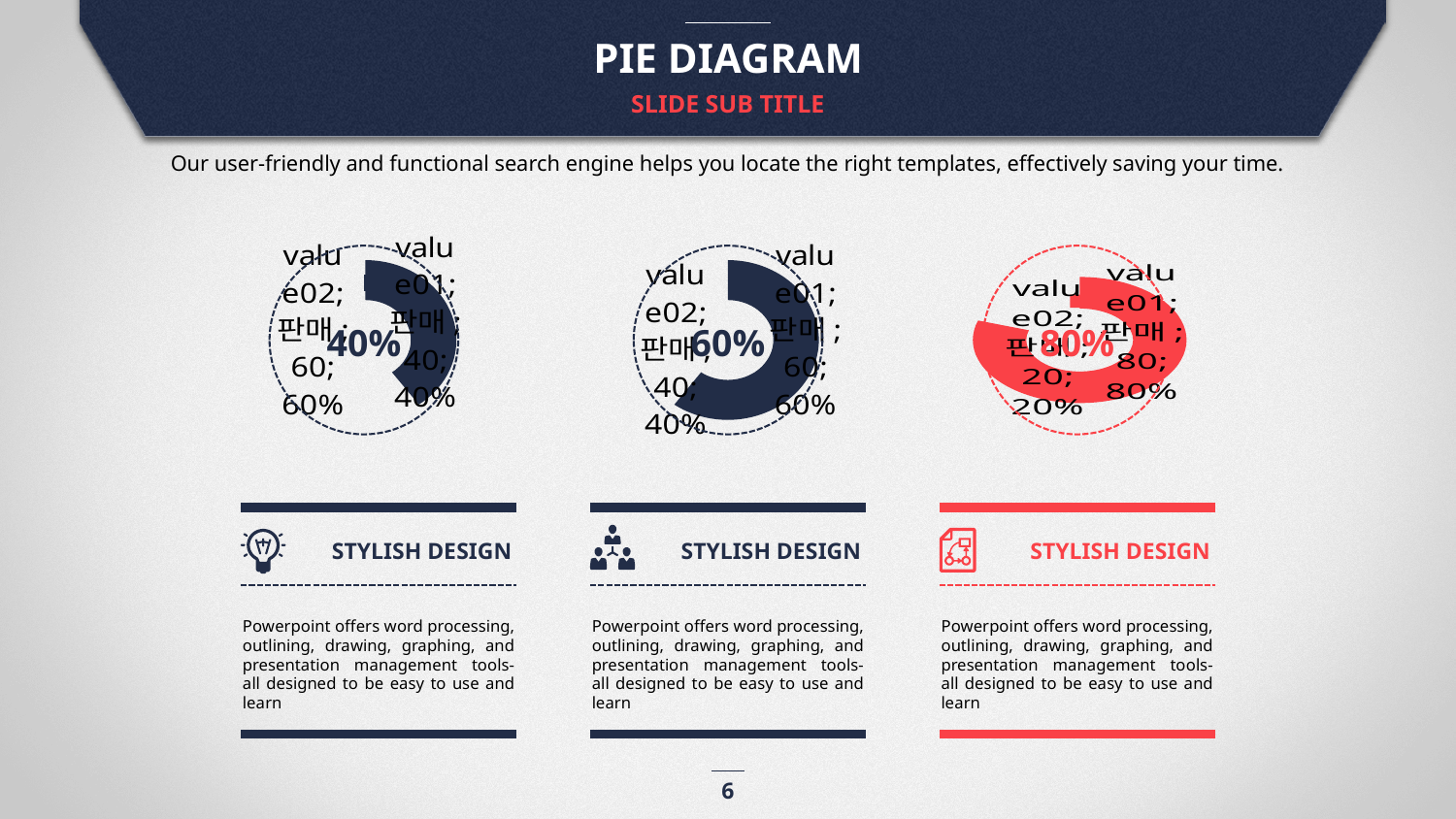
In the middle chart, what percentage is shown in the centre? 60% In the right chart, what is the value for value02? 20 In the left chart, what percentage is shown in the centre? 40% What colour is the right chart drawn in? red In the middle chart, what is the value for value01? 60 In the right chart, what share of the whole does value01 represent? 80% In the right chart, what percentage is shown in the centre? 80% In the right chart, what is the difference between the value01 and value02 values? 60 How many slices does each doughnut chart on the slide have? 2 What type of chart is shown on the left of the slide? doughnut chart In the left chart, what is the value for value02? 60 In the left chart, which slice is larger, value01 or value02? value02